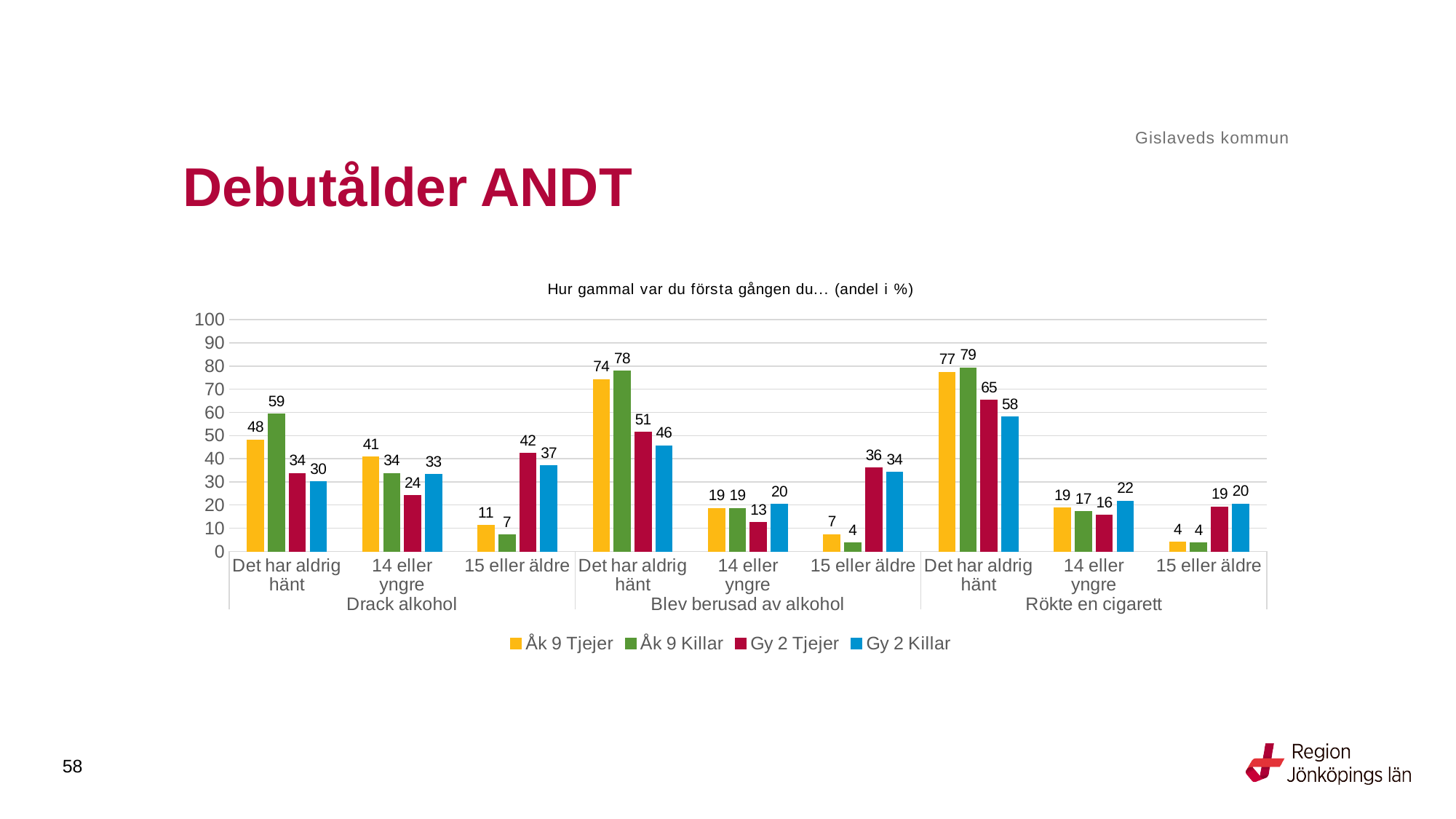
How many category groups (bar clusters) are shown along the x axis? 9 How many series does the legend list? 4 What is the value for Gy 2 Killar in the '14 eller yngre' category under 'Rökte en cigarett'? 22 What kind of chart is shown on the slide? Bar chart Is the value for Gy 2 Tjejer in the 'Det har aldrig hänt' category under 'Rökte en cigarett' greater or less than 60? greater What is the value for Gy 2 Tjejer in the '15 eller äldre' category under 'Blev berusad av alkohol'? 36 Which series has the lowest value in the '15 eller äldre' category under 'Drack alkohol'? Åk 9 Killar Which is larger: Åk 9 Tjejer or Gy 2 Tjejer in the '14 eller yngre' category under 'Drack alkohol'? Åk 9 Tjejer What is the value for Åk 9 Killar in the 'Det har aldrig hänt' category under 'Drack alkohol'? 59 What is the title of the chart? Hur gammal var du första gången du… (andel i %) What is the difference between Åk 9 Killar and Gy 2 Killar in the 'Det har aldrig hänt' category under 'Blev berusad av alkohol'? 32 Which series has the highest value in the 'Det har aldrig hänt' category under 'Rökte en cigarett'? Åk 9 Killar